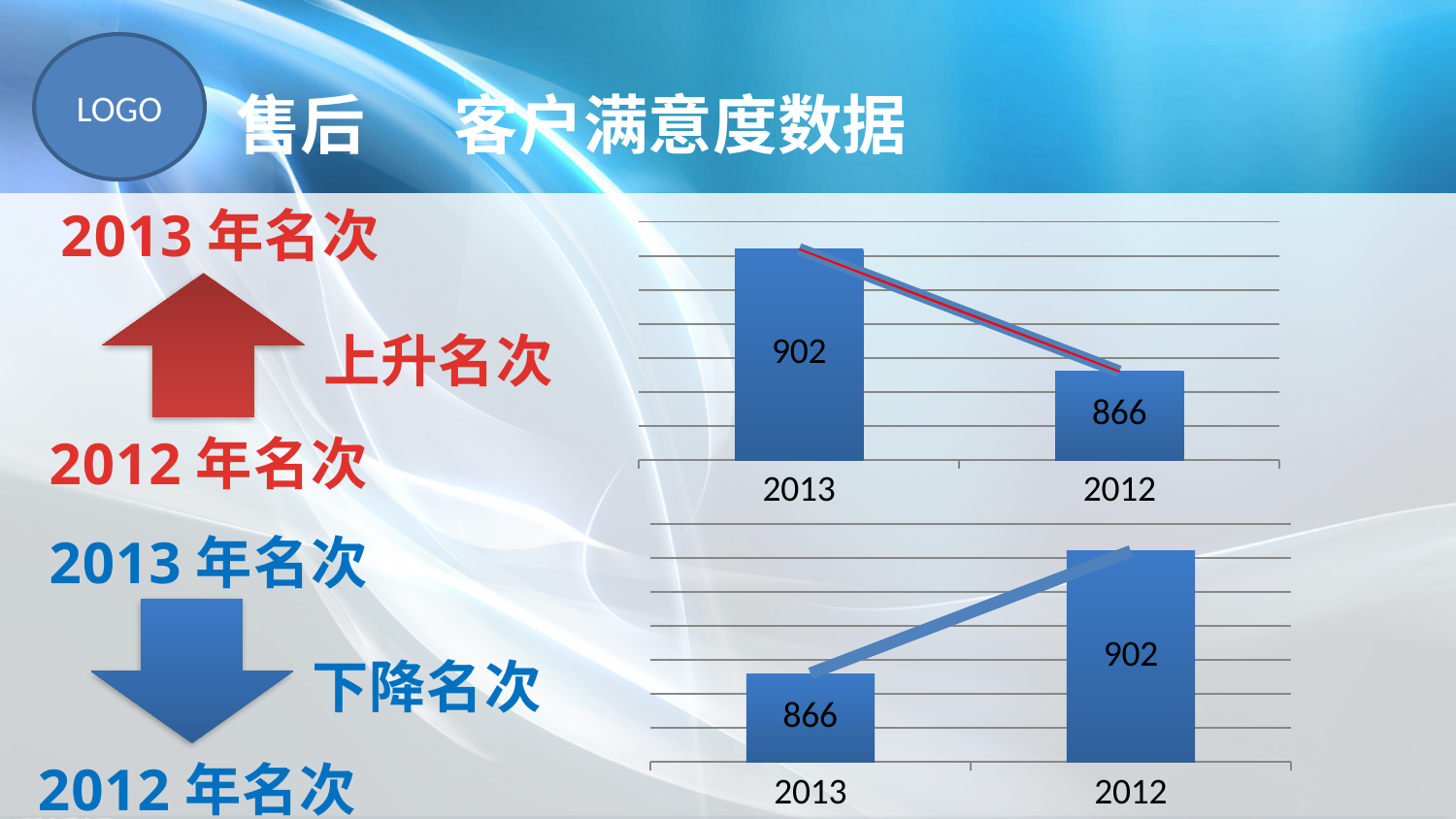
In the top chart, what is the value for 2013? 902 In the bottom chart, which category has the lowest value? 2013 In the top chart, what is the difference between the values for 2013 and 2012? 36 In the top chart, do the values rise or fall from left to right along the x axis? fall In the bottom chart, what is the difference between the values for 2012 and 2013? 36 In the top chart, what is the value for 2012? 866 In the bottom chart, what is the value for 2012? 902 In the bottom chart, what is the value for 2013? 866 How many categories are shown in the top chart? 2 In the bottom chart, which is larger, the value for 2013 or the value for 2012? 2012 In the top chart, which category has the highest value? 2013 What kind of chart is the bottom chart? bar chart